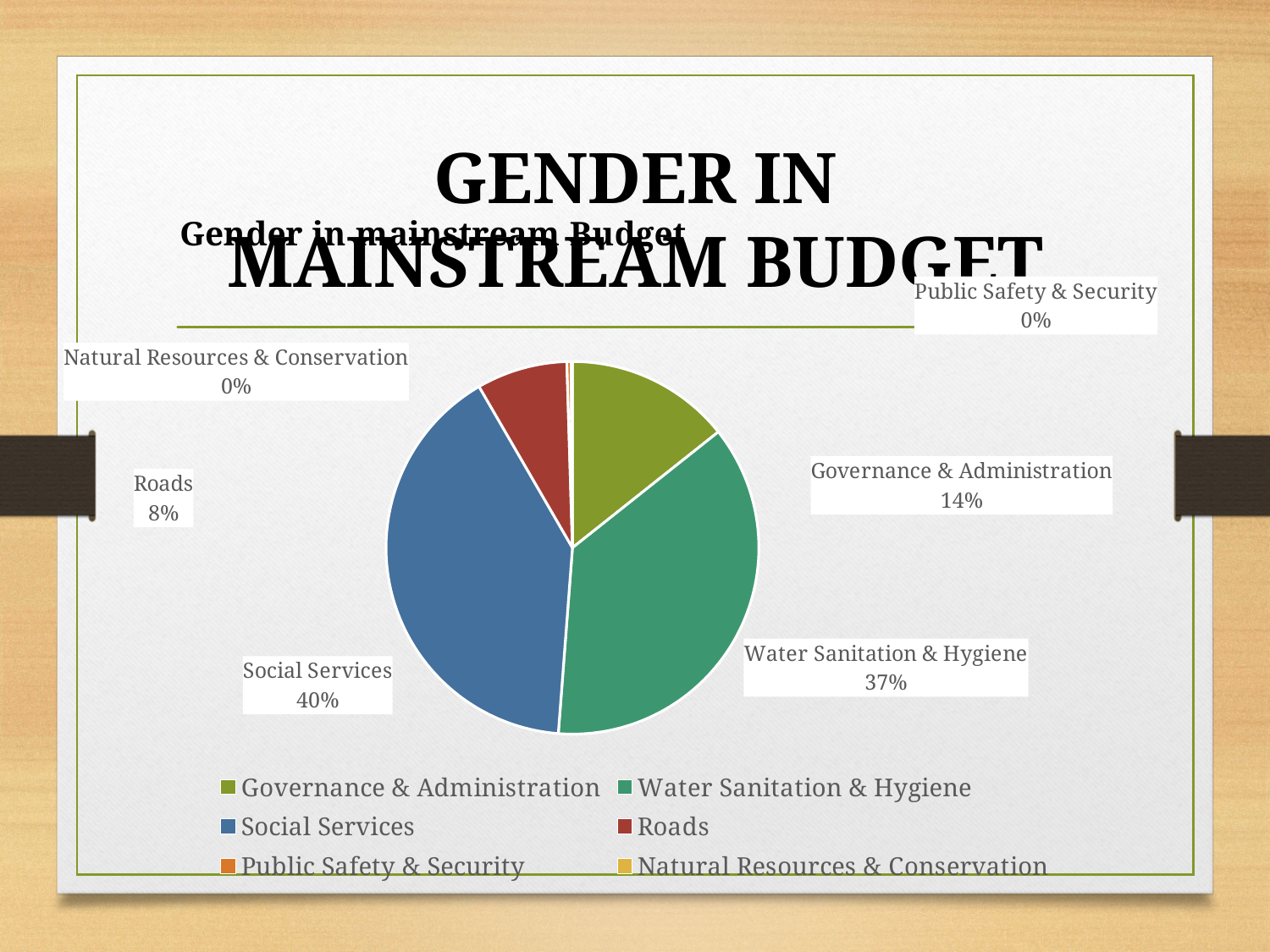
What share of the pie does Social Services have? 40% What is the difference between the shares of Governance & Administration and Roads? 6% What kind of chart is shown on the slide? pie chart What is the difference between the shares of Social Services and Water Sanitation & Hygiene? 3% What is the value shown for Roads? 8% Which category has the largest share of the pie? Social Services What is the value shown for Public Safety & Security? 0% What is the value shown for Water Sanitation & Hygiene? 37% What colour is the Social Services slice? blue Which is larger, the share for Governance & Administration or the share for Roads? Governance & Administration What is the value shown for Governance & Administration? 14% How many categories does the legend list? 6